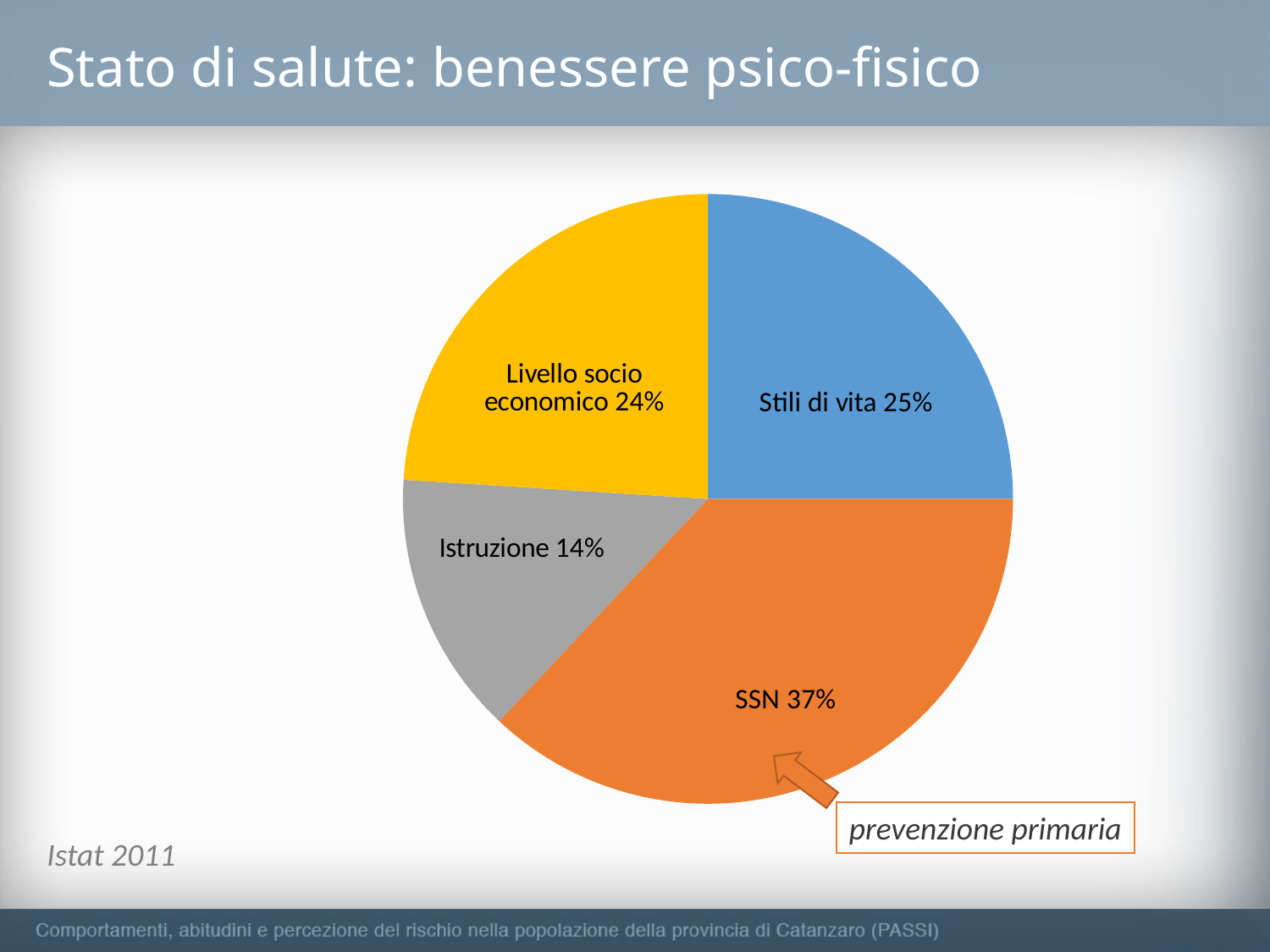
What is the value for Istruzione? 14% How many slices does the pie chart have? 4 Which is larger, the value for SSN or the value for Stili di vita? SSN Which slice of the pie is the largest? SSN What text is in the box that the arrow points from near the SSN slice? prevenzione primaria What is the value for Stili di vita? 25% What is the difference between the SSN value and the Istruzione value? 23% What is the value for SSN? 37% What kind of chart is shown on the slide? pie chart What colour is the SSN slice? orange Which slice of the pie is the smallest? Istruzione What is the value for Livello socio economico? 24%